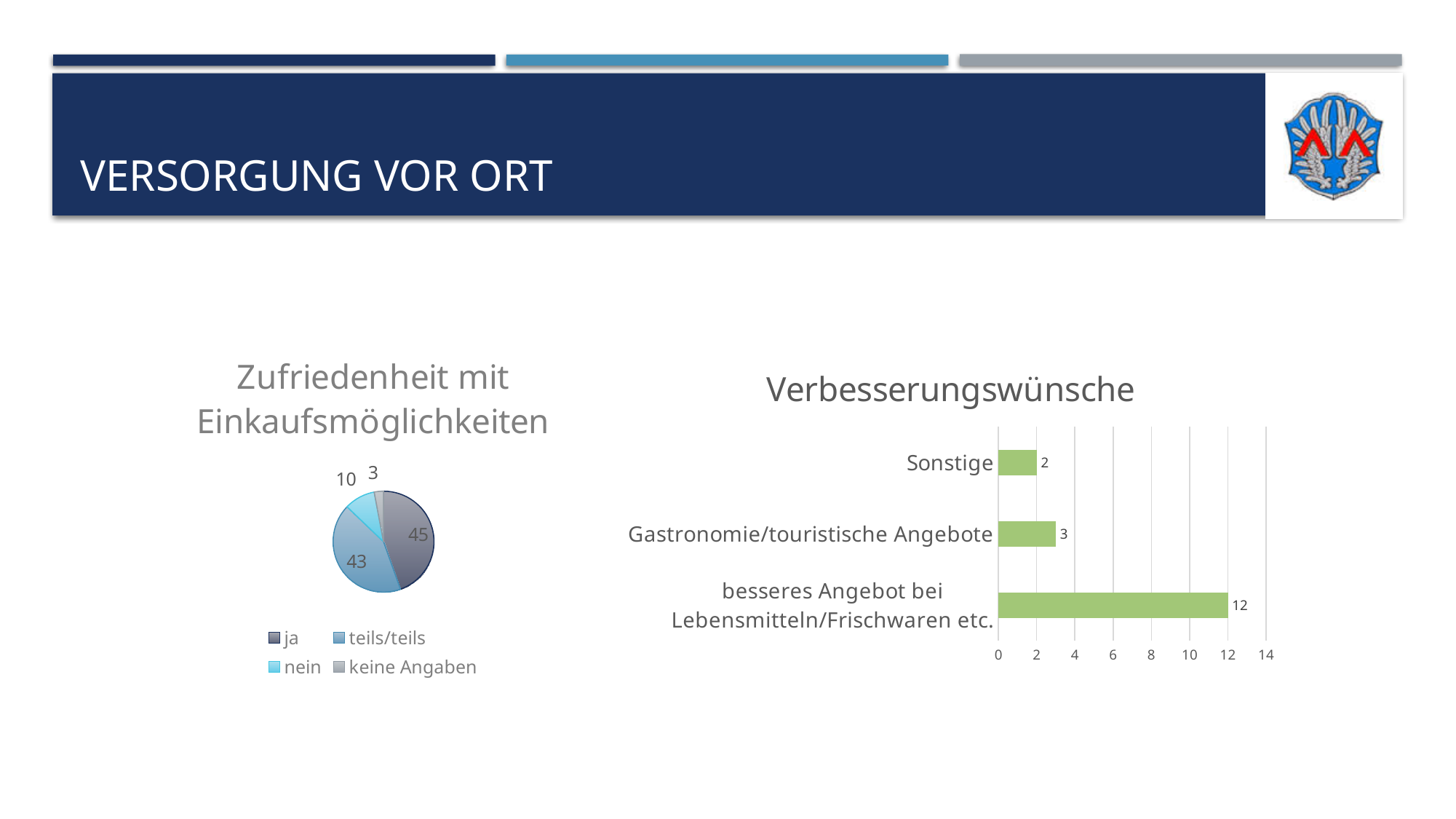
In the 'Zufriedenheit mit Einkaufsmöglichkeiten' chart, what is the value for 'ja'? 45 In the 'Zufriedenheit mit Einkaufsmöglichkeiten' chart, which category has the smallest slice? keine Angaben What kind of chart is 'Zufriedenheit mit Einkaufsmöglichkeiten'? pie chart What kind of chart is 'Verbesserungswünsche'? bar chart In the 'Zufriedenheit mit Einkaufsmöglichkeiten' chart, what is the difference between 'ja' and 'teils/teils'? 2 In the 'Zufriedenheit mit Einkaufsmöglichkeiten' chart, what is the value for 'nein'? 10 In the 'Verbesserungswünsche' chart, which category has the highest value? besseres Angebot bei Lebensmitteln/Frischwaren etc. In the 'Zufriedenheit mit Einkaufsmöglichkeiten' chart, how many categories does the legend list? 4 In the 'Verbesserungswünsche' chart, how many categories are shown? 3 In the 'Verbesserungswünsche' chart, what is the difference between 'besseres Angebot bei Lebensmitteln/Frischwaren etc.' and 'Sonstige'? 10 In the 'Verbesserungswünsche' chart, what is the value for 'Gastronomie/touristische Angebote'? 3 In the 'Verbesserungswünsche' chart, what is the value for 'Sonstige'? 2